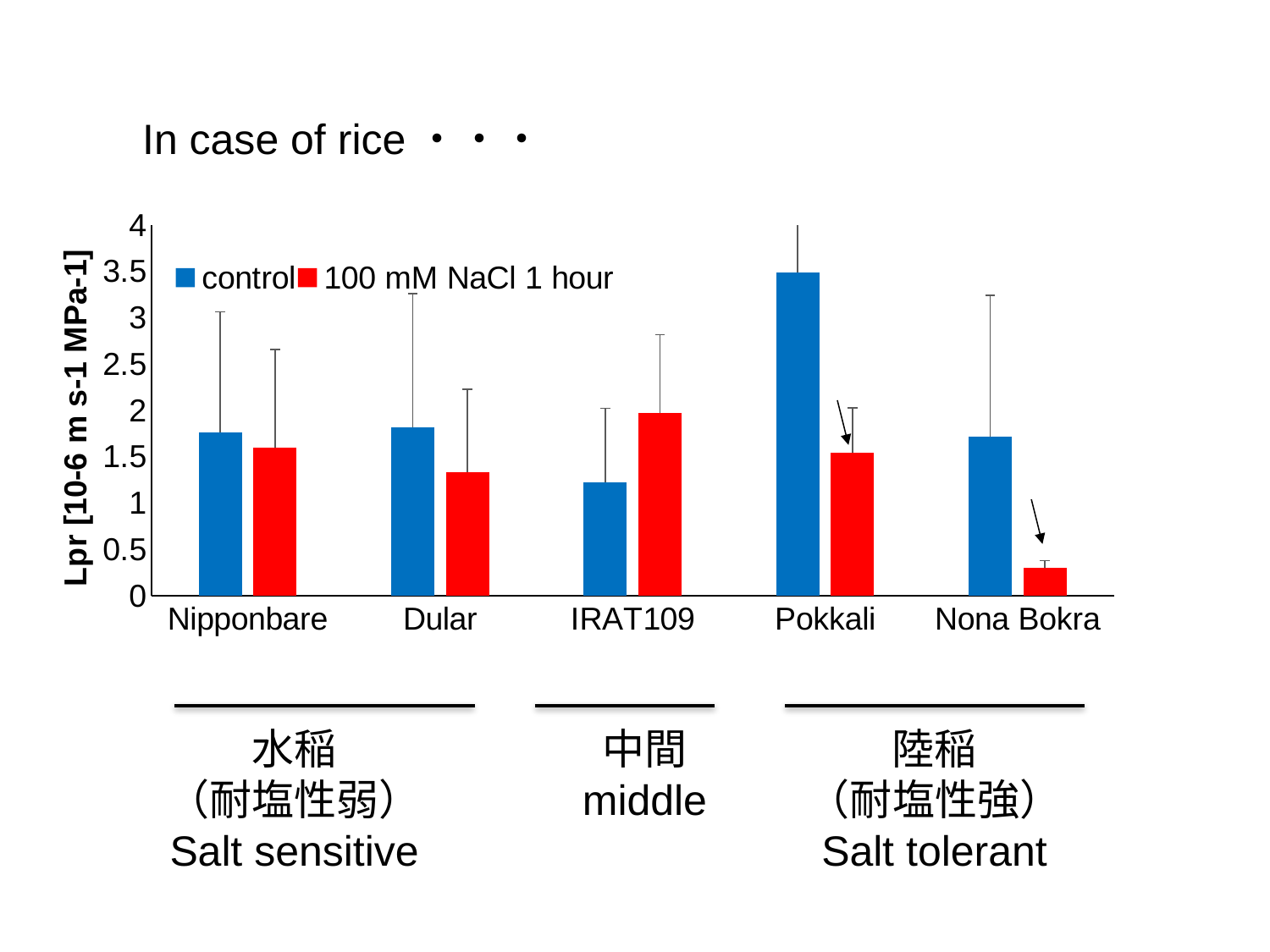
For IRAT109, which is larger: the control value or the 100 mM NaCl 1 hour value? 100 mM NaCl 1 hour Is the control value for Pokkali greater or less than 3? greater Which rice variety has the lowest value for 100 mM NaCl 1 hour? Nona Bokra Is the 100 mM NaCl 1 hour value for IRAT109 greater or less than 1.5? greater What are the two series named in the chart's legend? control and 100 mM NaCl 1 hour How many series does the chart's legend list? 2 How many rice varieties are shown on the x axis of the chart? 5 For Pokkali, which is larger: the control value or the 100 mM NaCl 1 hour value? control Is the 100 mM NaCl 1 hour value for Nona Bokra greater or less than 0.5? less Which rice variety has the highest control value? Pokkali What kind of chart is shown on the slide? bar chart Which rice variety has the lowest control value? IRAT109